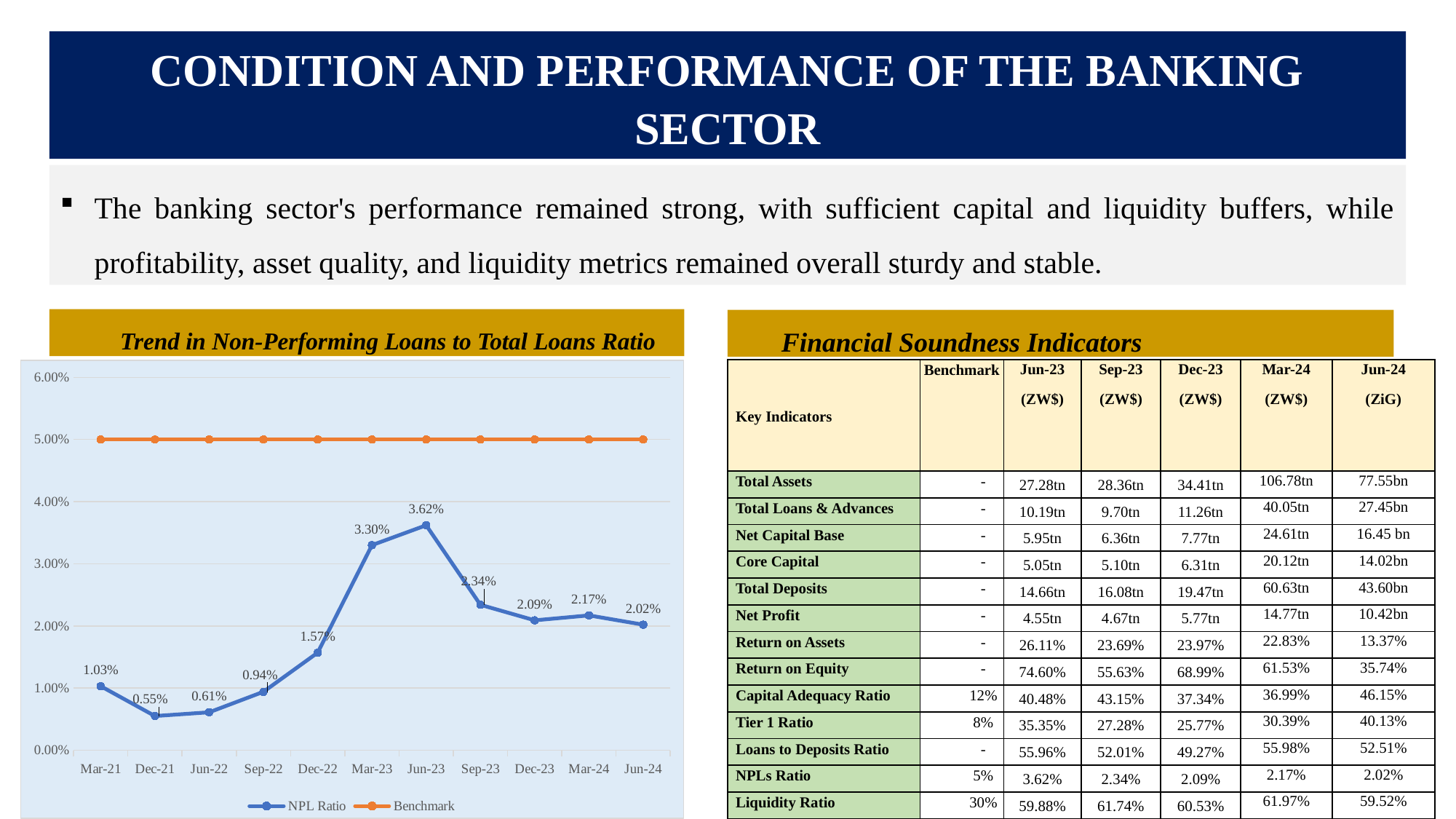
Which period has the highest NPL Ratio in the chart? Jun-23 Is the Benchmark value in the chart greater or less than 4.00%? greater Which is larger, the NPL Ratio in Mar-23 or in Dec-22? Mar-23 What is the NPL Ratio for Dec-21 in the chart? 0.55% What is the difference between the NPL Ratio in Jun-23 and Sep-23? 1.28% How many series does the chart's legend list? 2 Which period has the lowest NPL Ratio in the chart? Dec-21 What is the NPL Ratio for Jun-23 in the chart? 3.62% What type of chart is shown under the title 'Trend in Non-Performing Loans to Total Loans Ratio'? Line chart Does the NPL Ratio rise or fall from Dec-21 to Jun-23? Rise What is the NPL Ratio for Jun-24 in the chart? 2.02% How many time periods are plotted on the x axis of the chart? 11